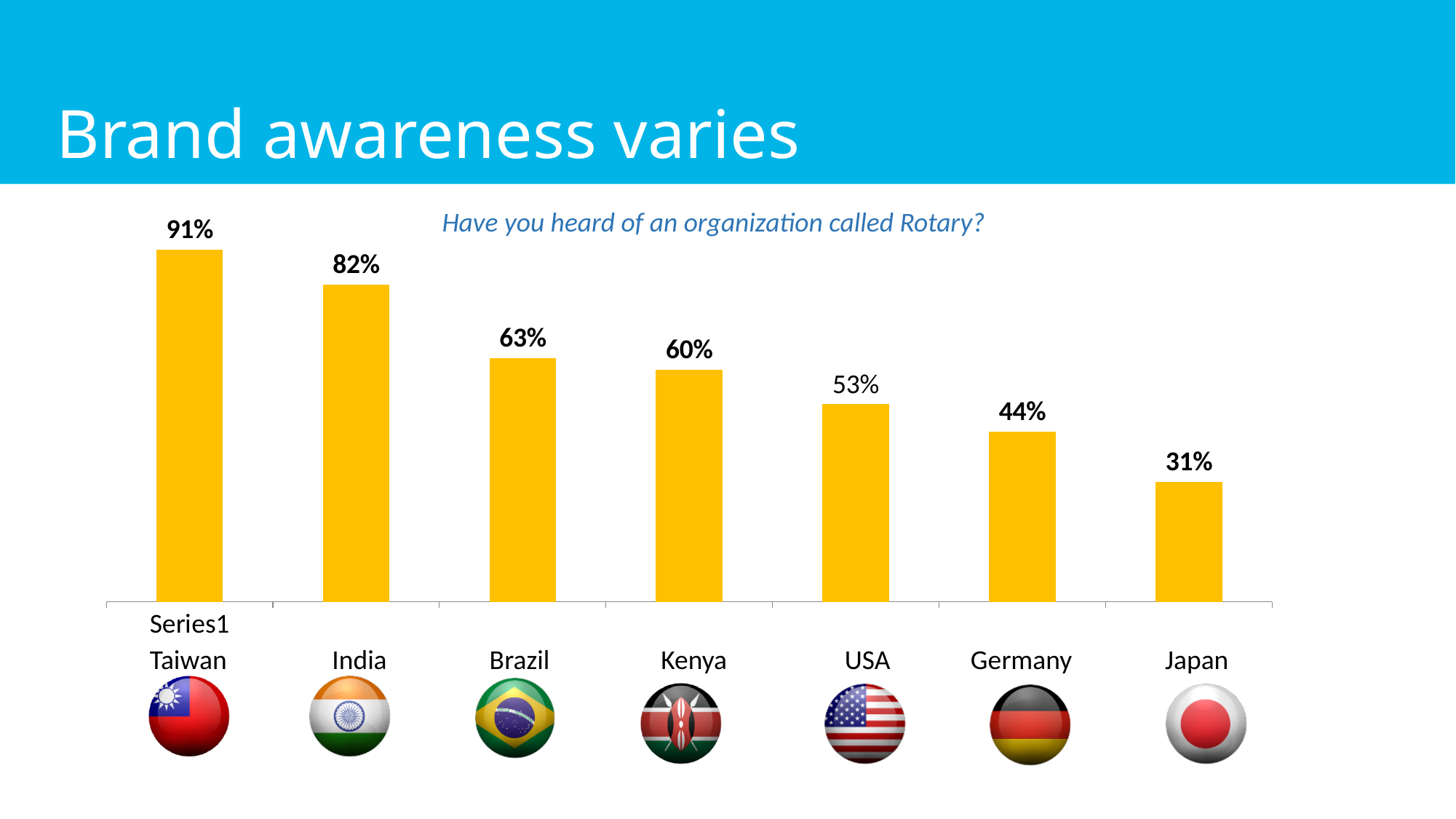
What is the difference between the values for India and USA? 29% What survey question is shown above the chart? Have you heard of an organization called Rotary? Do the values rise or fall from left to right across the countries? Fall What kind of chart is shown on the slide? Bar chart Which has a higher value, Brazil or Germany? Brazil What percentage of respondents in Taiwan have heard of Rotary? 91% What is the difference between the values for Brazil and Japan? 32% What is the value shown for Germany? 44% How many countries are shown in the chart? 7 Which country has the highest brand awareness value? Taiwan What is the value shown for Kenya? 60% Which country has the lowest brand awareness value? Japan